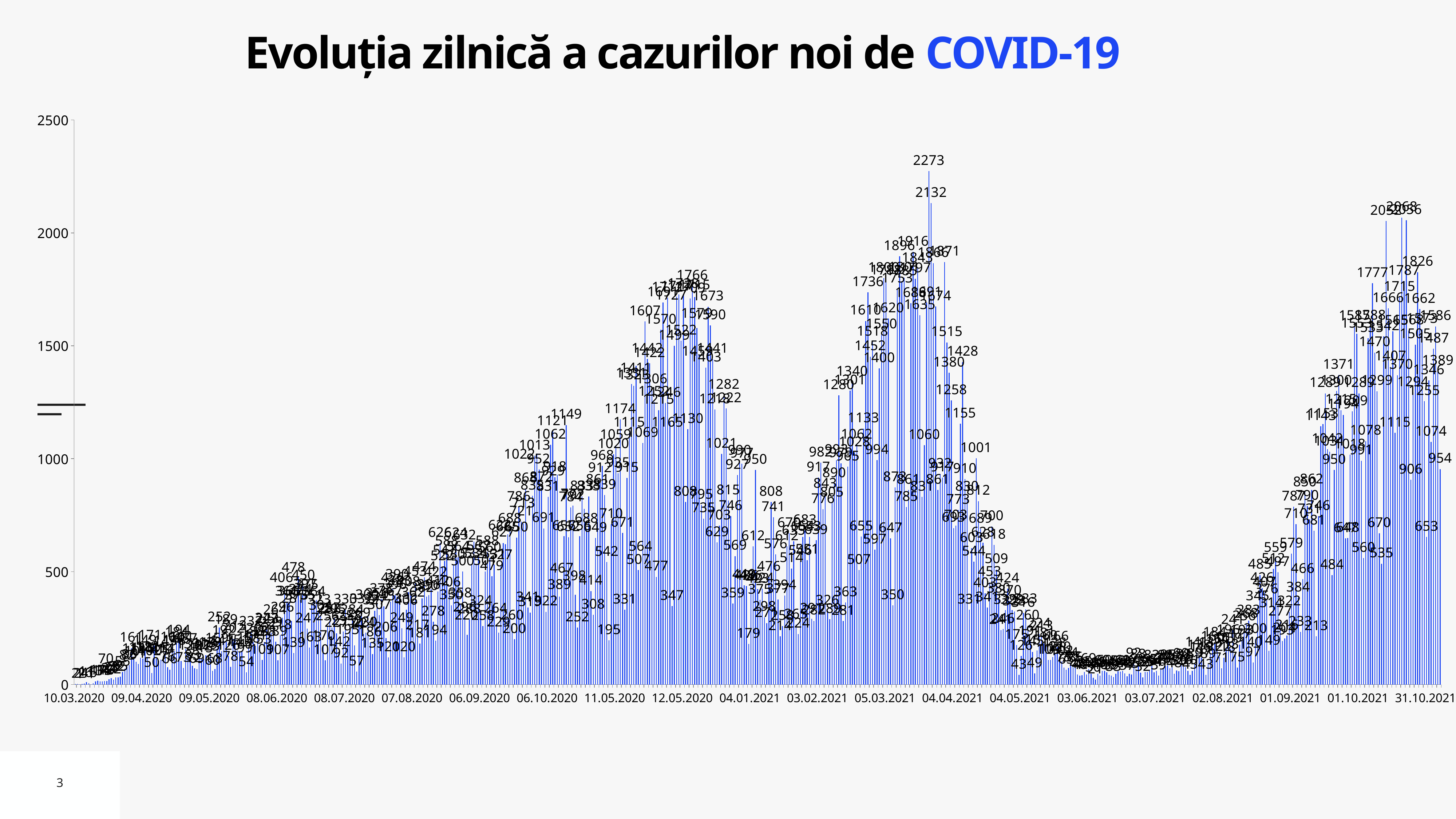
What is the highest tick value shown on the vertical axis? 2500 What is the highest daily value labeled on the chart? 2273 Is the value at the first date, 10.03.2020, greater or less than 500? less What is the difference between the two highest labeled values, 2273 and 2132? 141 Which peak is higher: the one near 04.04.2021 or the one near 12.05.2020? the one near 04.04.2021 What is the title of the chart on the slide? Evoluția zilnică a cazurilor noi de COVID-19 Do the values rise or fall between 03.06.2021 and 31.10.2021? rise What kind of chart is shown on the slide? bar chart Do the values rise or fall between 04.04.2021 and 03.06.2021? fall Is the highest value on the chart greater or less than 2000? greater What is the second highest daily value labeled on the chart, next to the 2273 peak? 2132 Are the values around 03.06.2021 greater or less than 500? less